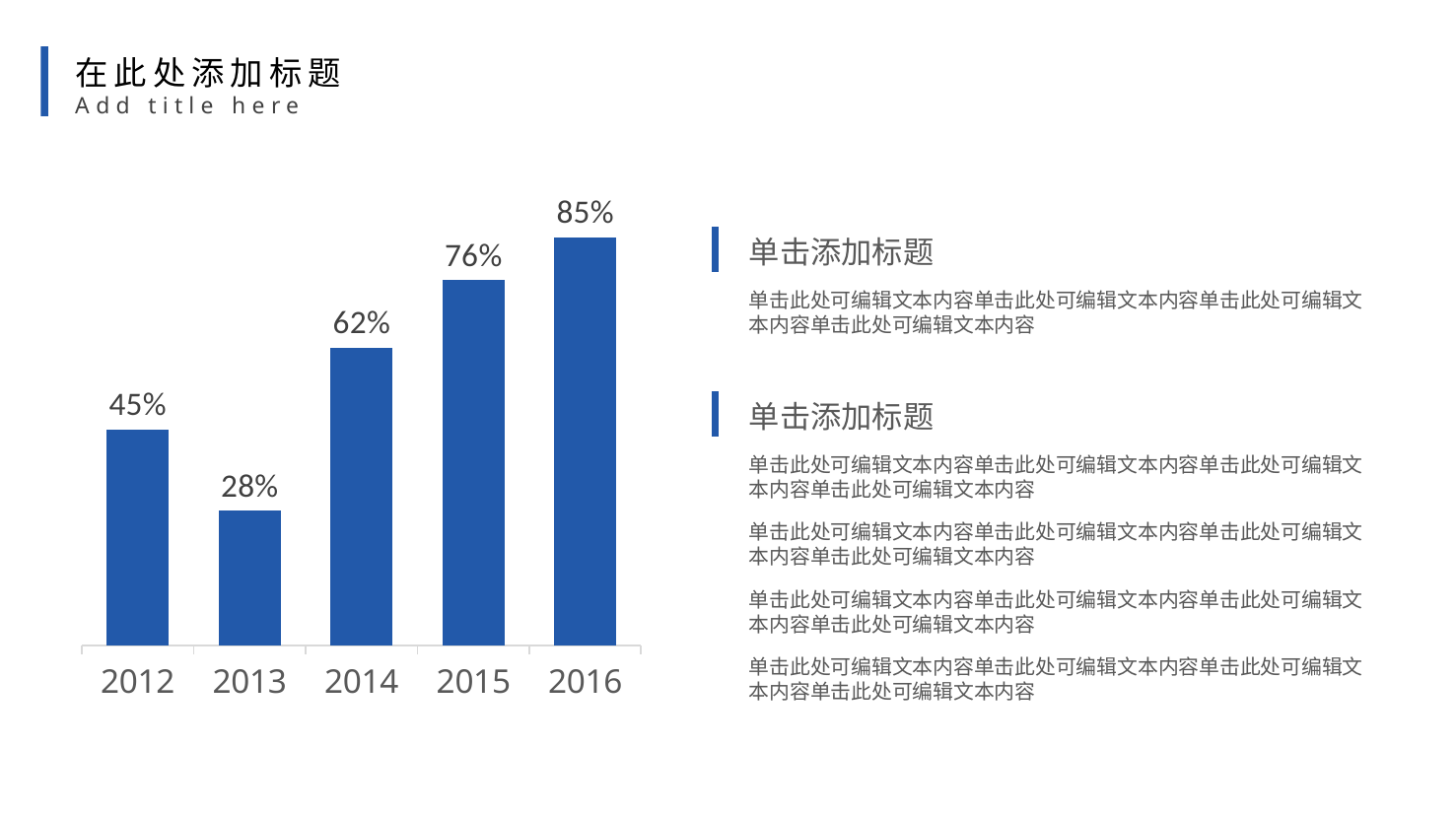
Which is larger, the value for 2014 or the value for 2012? 2014 What is the value for 2016? 85% Which year has the lowest value? 2013 What is the value for 2012? 45% What is the difference between the values for 2016 and 2015? 9% What kind of chart is shown on the slide? bar chart What is the difference between the values for 2012 and 2013? 17% Do the values rise or fall from 2013 to 2016? rise What is the value for 2013? 28% Which year has the highest value? 2016 What is the value for 2014? 62% How many years are shown on the x axis? 5